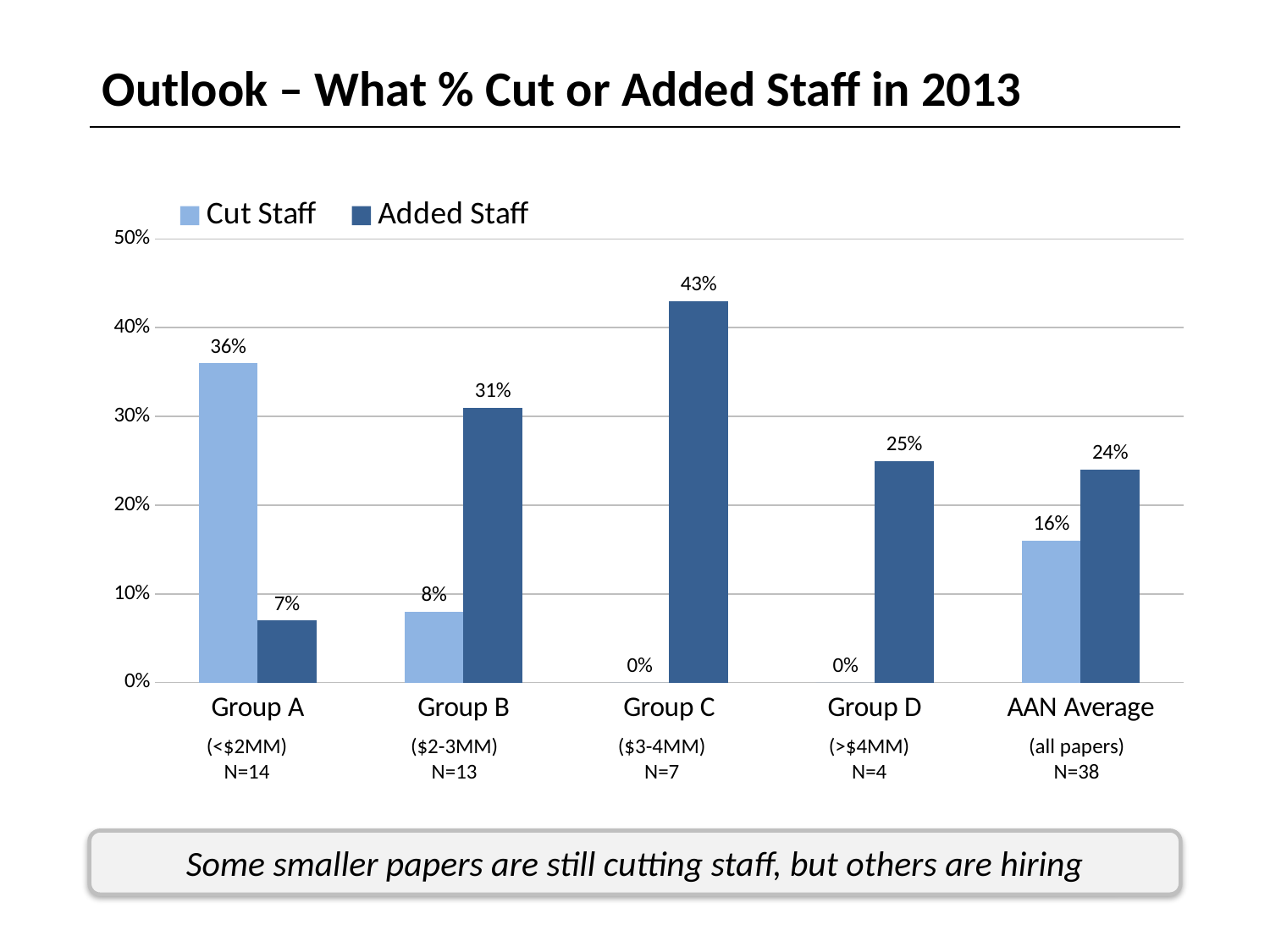
What is the Cut Staff value for Group D? 0% How many categories are shown on the x axis? 5 Which group has the highest Added Staff percentage? Group C What is the difference between the Added Staff and Cut Staff percentages for Group B? 23% What percentage of Group C added staff? 43% What kind of chart is shown on the slide? Bar chart Which is larger for the AAN Average: Cut Staff or Added Staff? Added Staff Which category has the highest Cut Staff percentage? Group A What percentage of Group A cut staff? 36% What is the Added Staff value for the AAN Average? 24% How many series does the legend list? 2 What is the sample size (N) for Group C? N=7